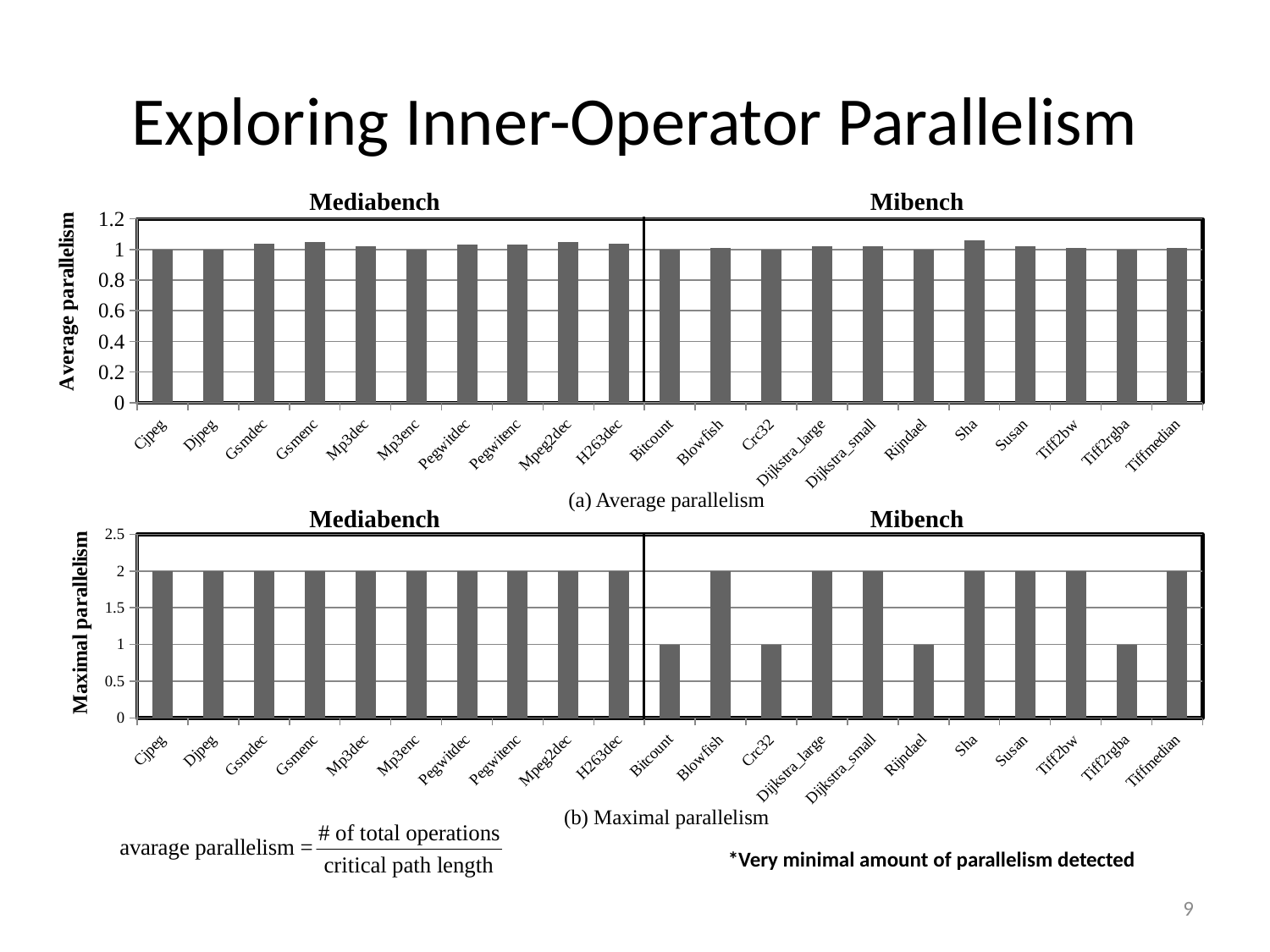
Which two benchmark suites are labelled above the charts? Mediabench and Mibench What kind of chart is the Maximal parallelism chart (b)? bar chart In the Average parallelism chart (a), is the value for Cjpeg greater or less than 0.8? greater In the Average parallelism chart (a), is the value for Sha greater or less than 1.2? less How many benchmark categories are plotted in the Average parallelism chart (a)? 21 In the Maximal parallelism chart (b), which is larger, the value for Blowfish or the value for Bitcount? Blowfish In the Maximal parallelism chart (b), what is the value for Rijndael? 1 In the Maximal parallelism chart (b), what is the value for Bitcount? 1 What is the y-axis label of the top chart (a)? Average parallelism In the Maximal parallelism chart (b), what is the value for Tiff2rgba? 1 In the Maximal parallelism chart (b), what is the difference between the values for Sha and Crc32? 1 In the Maximal parallelism chart (b), what is the value for Cjpeg? 2